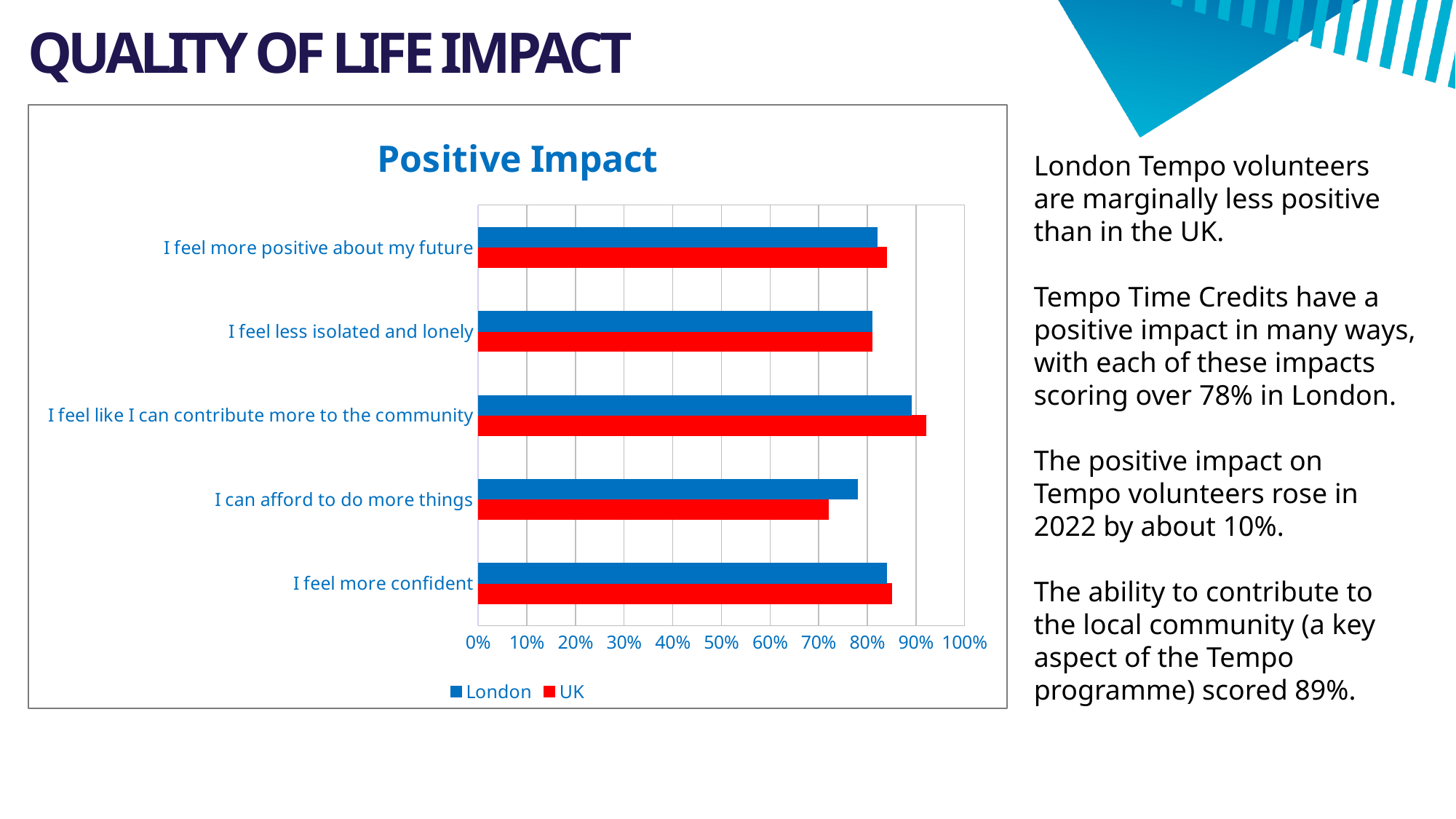
How many series does the legend of the "Positive Impact" chart list? 2 Is the London value for "I feel like I can contribute more to the community" greater or less than 80%? greater How many categories are plotted in the "Positive Impact" chart? 5 What kind of chart is shown under the title "Positive Impact"? bar chart Which category has the lowest UK value in the "Positive Impact" chart? I can afford to do more things For "I can afford to do more things", which is larger, the London value or the UK value? London Which category has the highest UK value in the "Positive Impact" chart? I feel like I can contribute more to the community Which colour represents the UK series in the "Positive Impact" chart? red Which category has the lowest London value in the "Positive Impact" chart? I can afford to do more things Which two series are listed in the legend of the "Positive Impact" chart? London and UK Which category has the highest London value in the "Positive Impact" chart? I feel like I can contribute more to the community Is the UK value for "I can afford to do more things" greater or less than 80%? less